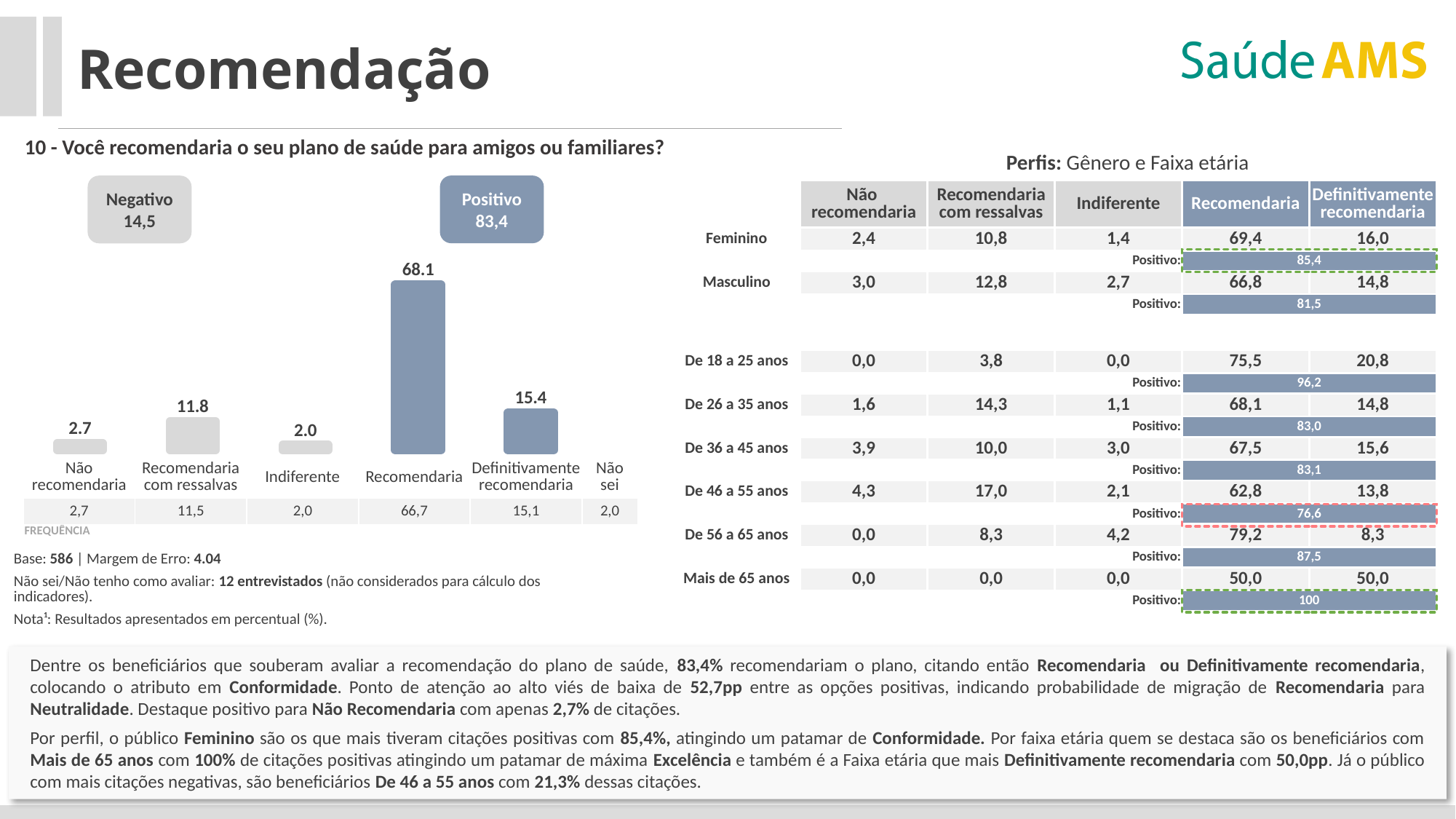
What is the value shown for Recomendaria in the bar chart? 68.1 What is the value shown for Indiferente in the bar chart? 2.0 What is the difference between the values for Recomendaria com ressalvas and Não recomendaria in the bar chart? 9.1 What kind of chart is shown on the left of the slide? Bar chart What is the value shown for Recomendaria com ressalvas in the bar chart? 11.8 What is the value shown for Definitivamente recomendaria in the bar chart? 15.4 Which category has the lowest bar in the chart? Indiferente What is the value shown for Não recomendaria in the bar chart? 2.7 Which is larger in the bar chart: Recomendaria com ressalvas or Definitivamente recomendaria? Definitivamente recomendaria Which category has the highest bar in the chart? Recomendaria What value is shown in the Positivo box above the bar chart? 83,4 What is the difference between the values for Recomendaria and Definitivamente recomendaria in the bar chart? 52.7